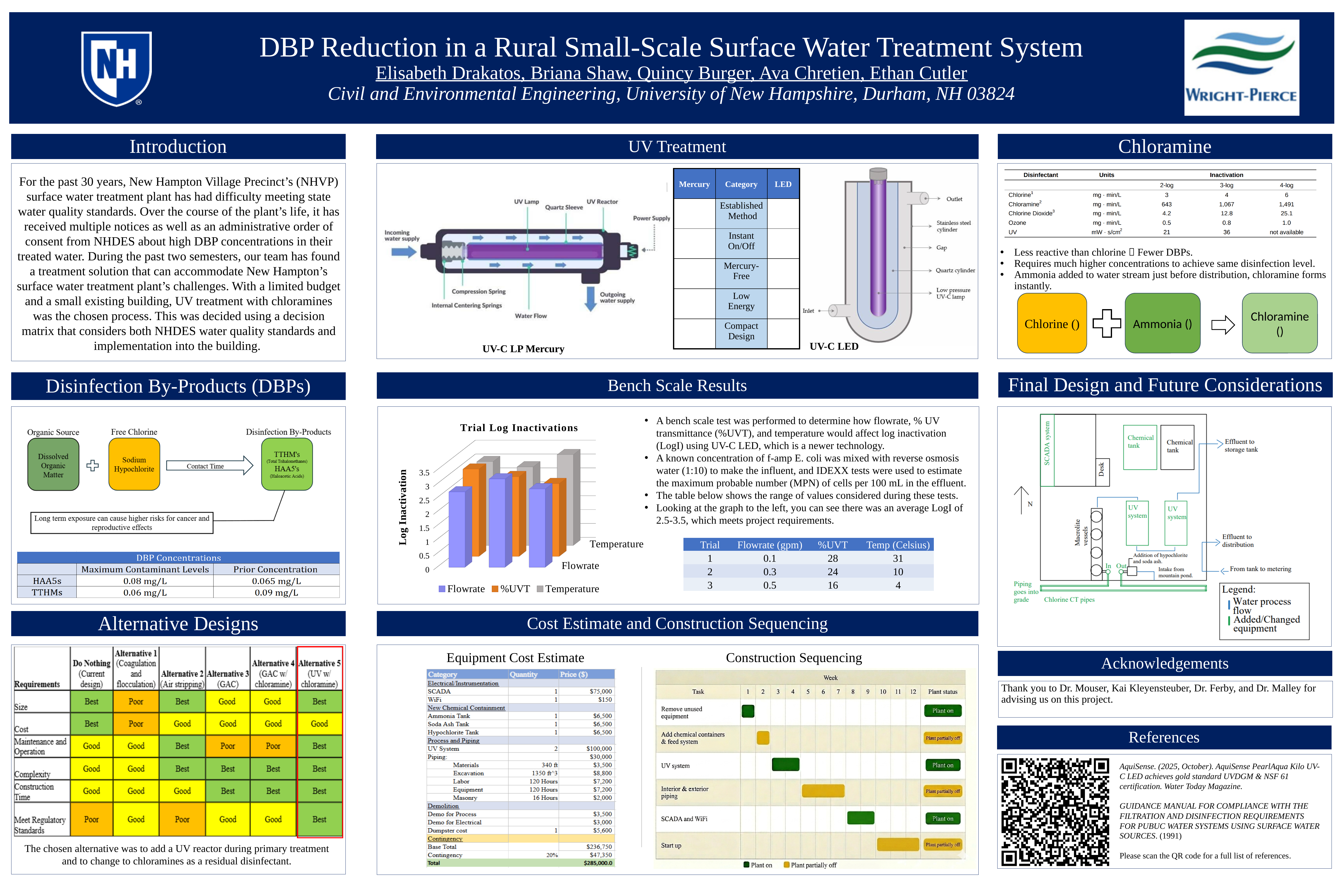
What are the series named in the legend of the "Trial Log Inactivations" chart? Flowrate, %UVT, Temperature In the "Construction Sequencing" chart, how many weeks are shown across the top? 12 How many series does the legend of the "Trial Log Inactivations" chart list? 3 How many groups of bars are plotted in the "Trial Log Inactivations" chart? 3 In the "Trial Log Inactivations" chart, which is taller in the first group, the Flowrate bar or the Temperature bar? Temperature What kind of chart is the "Trial Log Inactivations" chart? bar chart In the "Trial Log Inactivations" chart, is the Temperature bar in the first group greater or less than 2? greater In the "Trial Log Inactivations" chart, is the Flowrate bar in the first group greater or less than 3.5? less What is the highest tick value shown on the vertical axis of the "Trial Log Inactivations" chart? 3.5 In the "Trial Log Inactivations" chart, is the Flowrate bar in the third group greater or less than 1? greater What is the label on the vertical axis of the "Trial Log Inactivations" chart? Log Inactivation In the "Construction Sequencing" chart, how many tasks are listed? 6